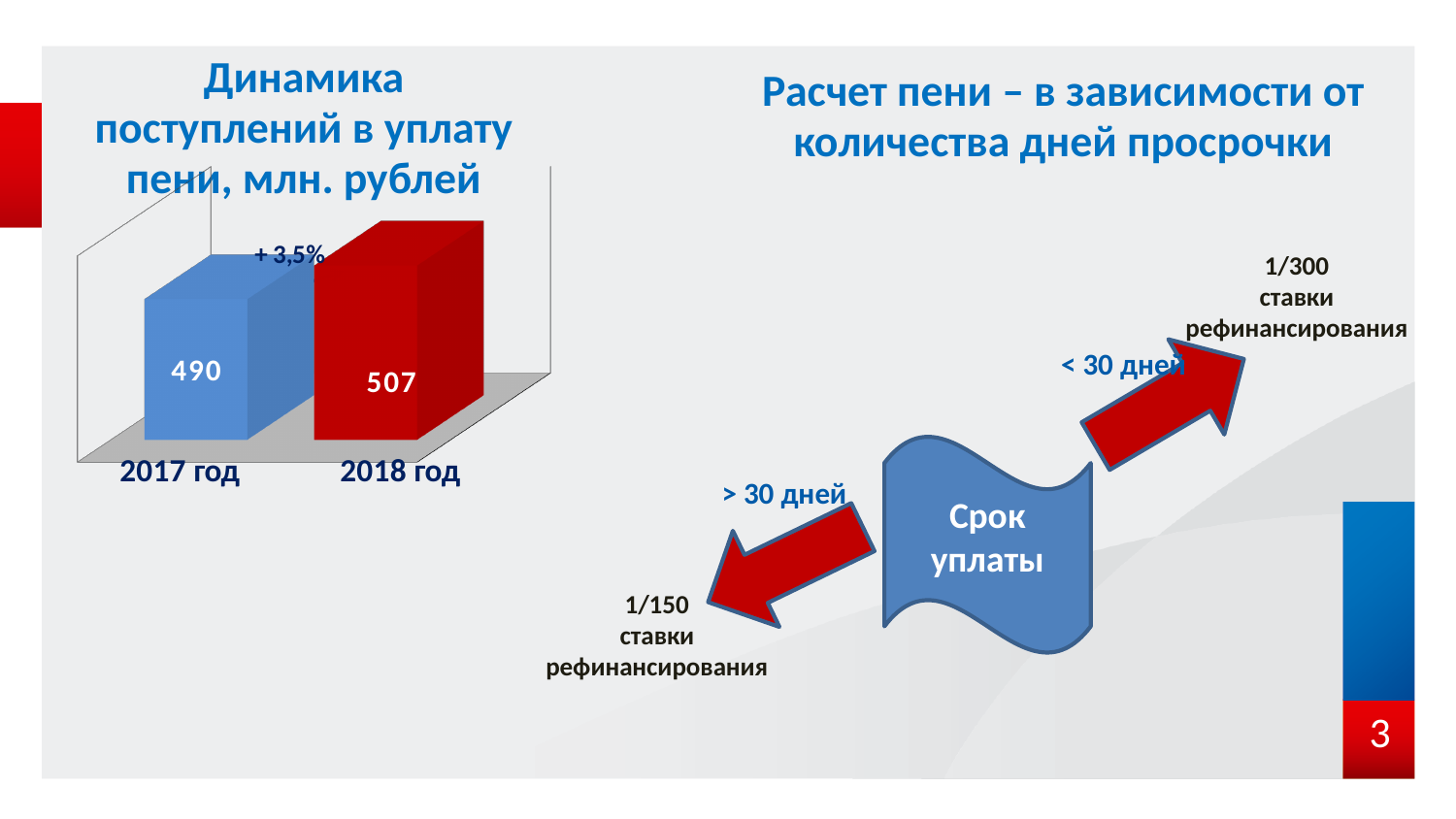
Do the values rise or fall from 2017 год to 2018 год? rise What kind of chart is shown on the slide? bar chart What is the value for 2018 год? 507 What is the value for 2017 год? 490 Which year has the higher value? 2018 год What is the title of the chart? Динамика поступлений в уплату пени, млн. рублей What is the difference between the values for 2018 год and 2017 год? 17 Is the value for 2018 год larger or smaller than the value for 2017 год? larger What percentage change is annotated between the two bars? + 3,5% Which year has the lower value? 2017 год How many bars are shown in the chart? 2